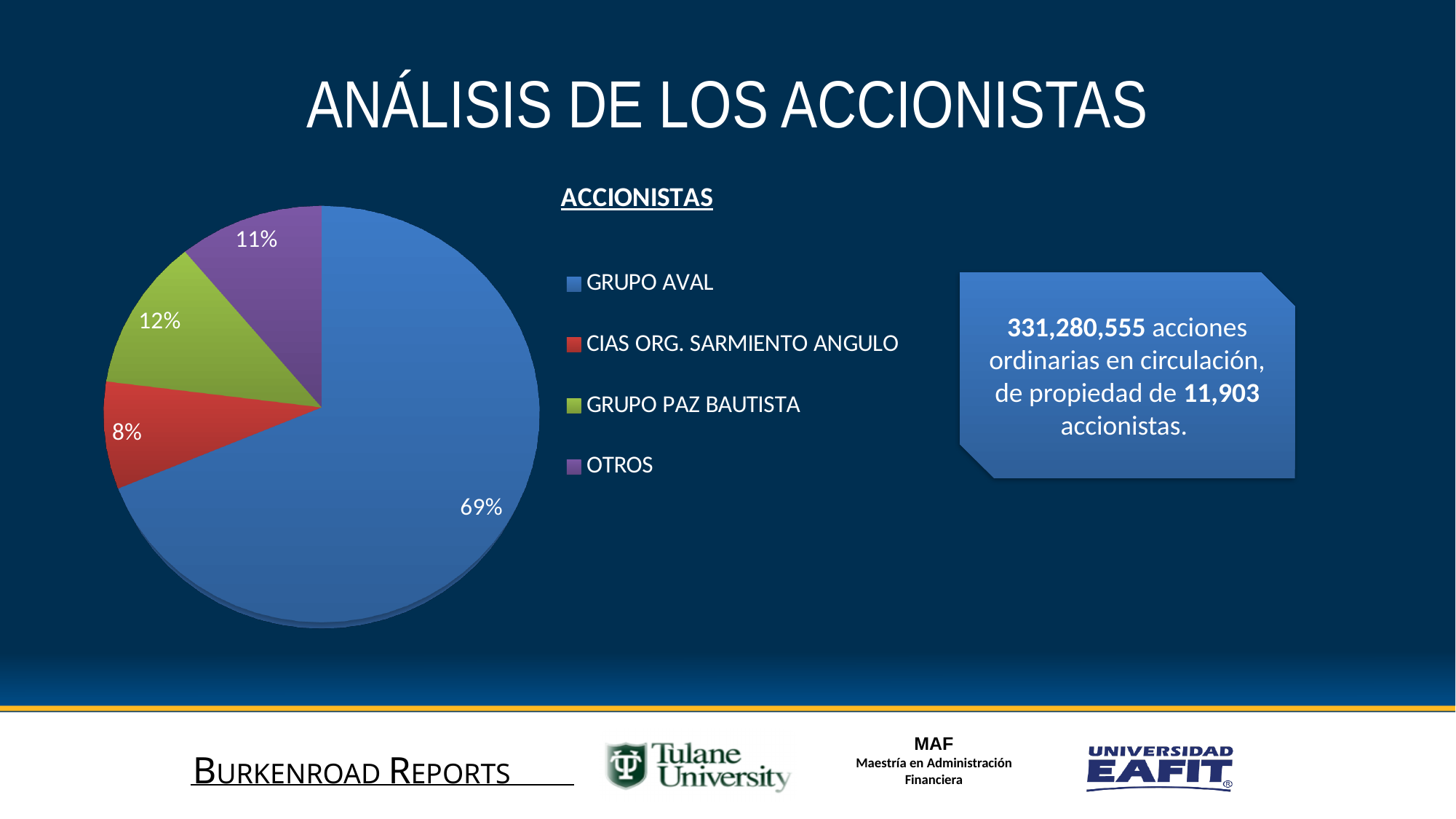
What share of the pie does GRUPO AVAL hold? 69% Which shareholder group has the smallest slice of the pie? CIAS ORG. SARMIENTO ANGULO How many slices does the pie chart have? 4 What share of the pie does OTROS hold? 11% What colour is the slice for OTROS? Purple What is the difference in percentage points between GRUPO AVAL and GRUPO PAZ BAUTISTA? 57 What type of chart is shown on the slide? Pie chart Which shareholder group has the largest slice of the pie? GRUPO AVAL What share of the pie does CIAS ORG. SARMIENTO ANGULO hold? 8% Which is larger, the share for GRUPO PAZ BAUTISTA or the share for OTROS? GRUPO PAZ BAUTISTA What is the title of the chart? ACCIONISTAS